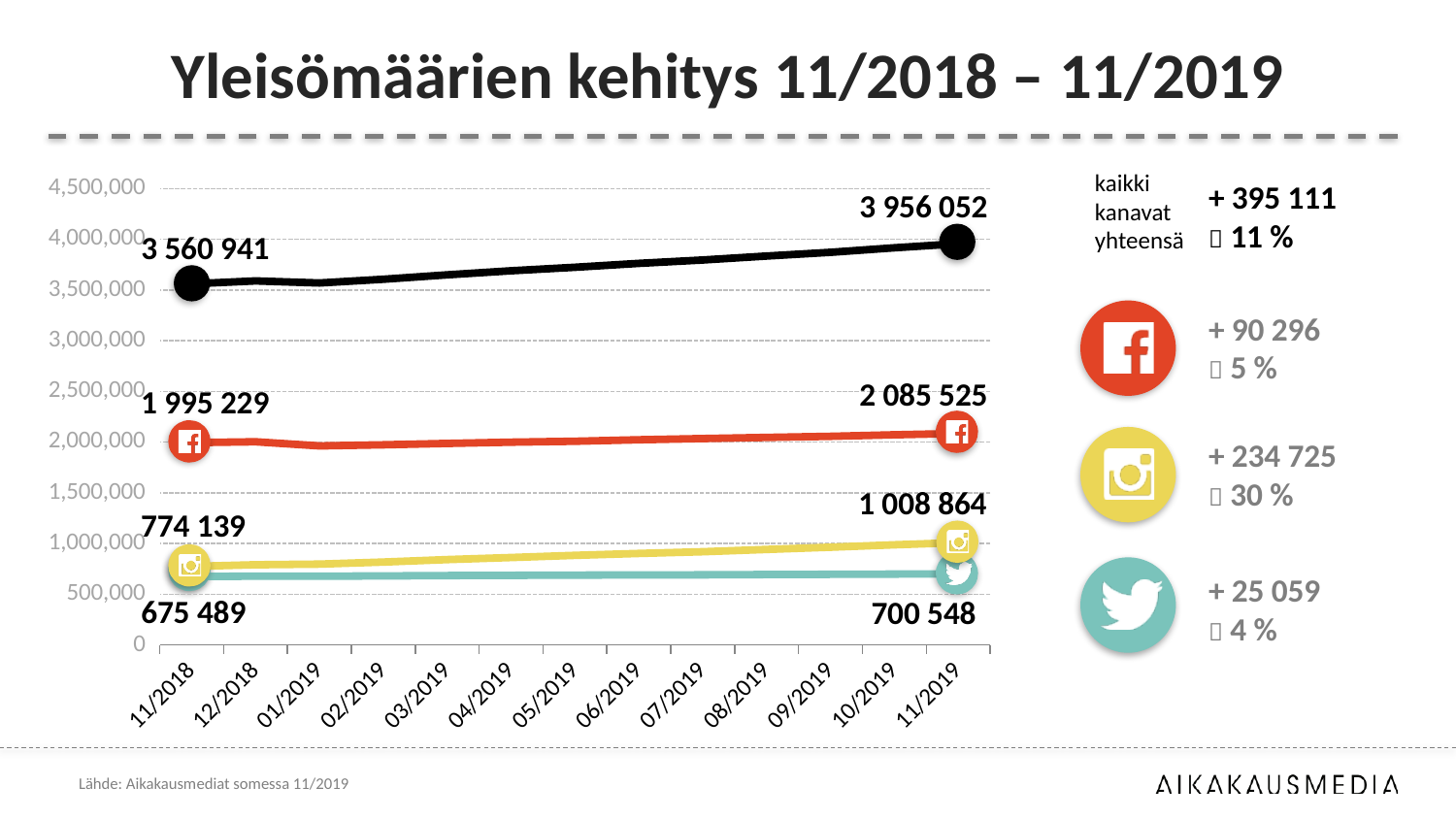
What is the value of the black (total) line at 11/2018? 3 560 941 By how much did the yellow Instagram line increase from 11/2018 to 11/2019? 234 725 What is the value of the teal Twitter line at 11/2019? 700 548 Does the black (total) line rise or fall from 11/2018 to 11/2019? rise What kind of chart is shown on the slide? line chart Which line has the lowest value at 11/2019? Twitter (teal) Which is larger at 11/2018: the Instagram value or the Twitter value? Instagram What is the value of the yellow Instagram line at 11/2018? 774 139 What is the value of the black (total) line at 11/2019? 3 956 052 What is the value of the red Facebook line at 11/2019? 2 085 525 By how much did the red Facebook line increase from 11/2018 to 11/2019? 90 296 How many months are shown on the x axis? 13